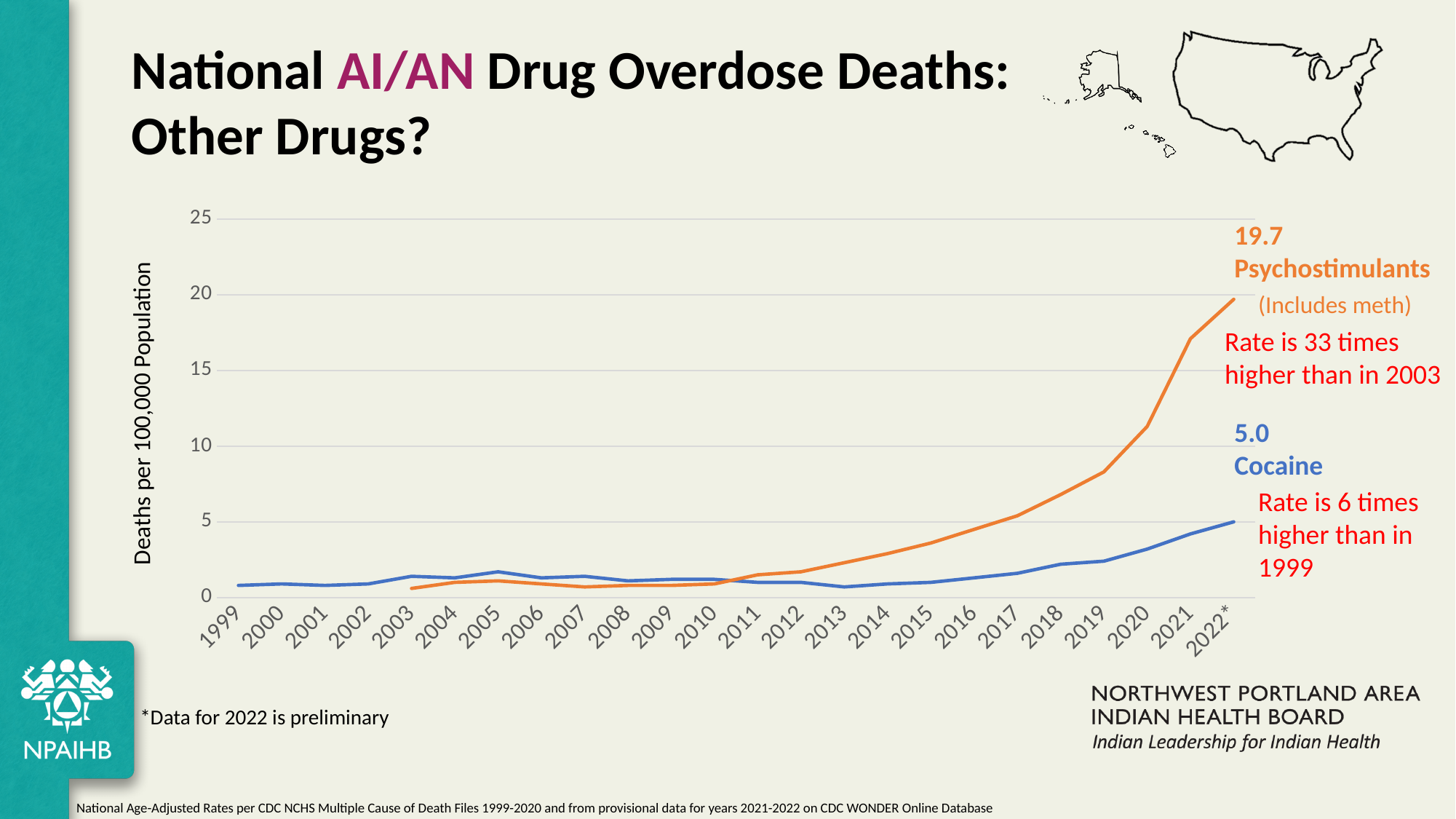
Is the value for Cocaine in 2019 greater or less than 5? less How many series are plotted on the chart? 2 In 2022*, which series has the larger value, Psychostimulants or Cocaine? Psychostimulants What is the value for Psychostimulants in 2022*? 19.7 How many years are shown on the x axis? 24 What is the label on the y axis of the chart? Deaths per 100,000 Population Does the Psychostimulants line rise or fall from 2010 to 2022*? rise Is the value for Psychostimulants in 2021 greater or less than 15? greater What is the value for Cocaine in 2022*? 5.0 What kind of chart is shown on the slide? line chart Is the value for Psychostimulants in 2017 greater or less than 10? less What is the difference between the Psychostimulants and Cocaine values in 2022*? 14.7